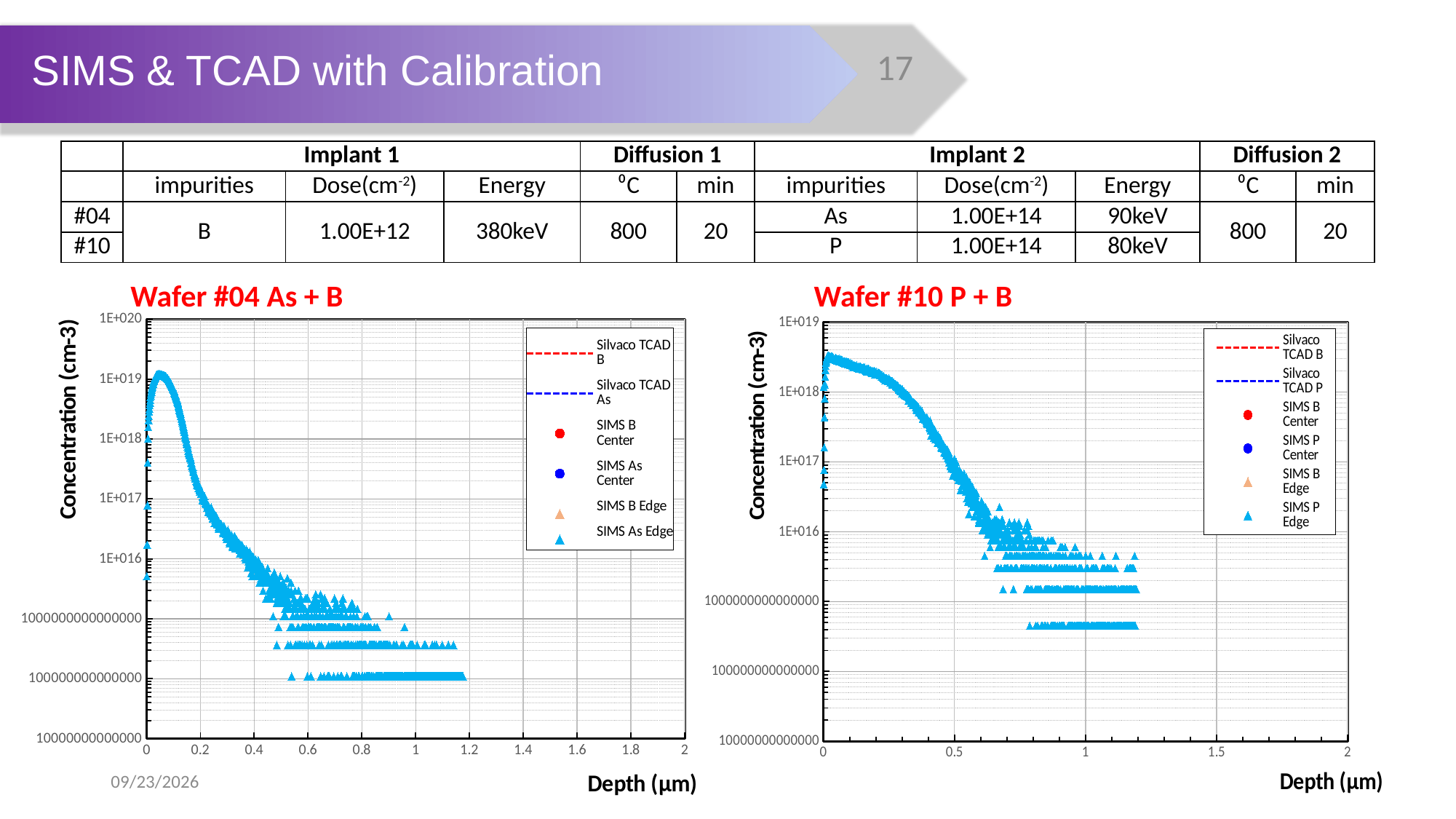
How many series does the legend of the 'Wafer #10 P + B' chart list? 6 In the 'Wafer #10 P + B' chart, does the concentration rise or fall as depth increases? fall In the 'Wafer #10 P + B' chart, is the peak concentration of the SIMS P Edge data greater or less than 1E+019? less In the 'Wafer #04 As + B' chart, is the concentration at a depth of 0.4 µm greater or less than 1E+017? less What kind of chart is the 'Wafer #04 As + B' chart? scatter chart What is the highest tick value on the x axis of the 'Wafer #10 P + B' chart? 2 How many series does the legend of the 'Wafer #04 As + B' chart list? 6 What is the y-axis label of the 'Wafer #04 As + B' chart? Concentration (cm-3) In the 'Wafer #04 As + B' chart, does the concentration rise or fall as depth increases beyond about 0.1 µm? fall In the 'Wafer #04 As + B' chart, is the peak concentration of the SIMS As Edge data greater or less than 1E+020? less